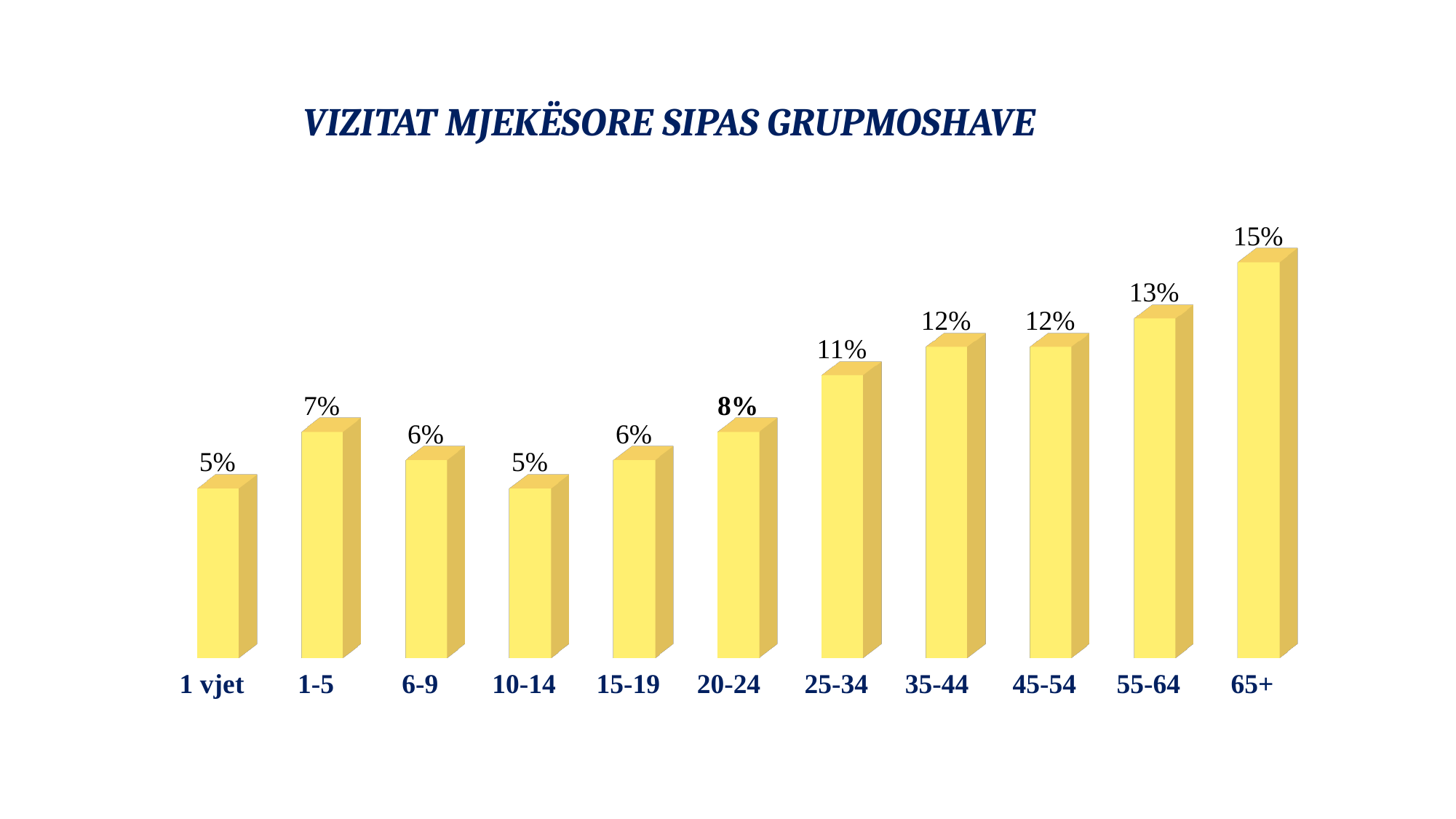
What kind of chart is shown on the slide? Bar chart Do the values generally rise or fall from the 15-19 group to the 65+ group? Rise What is the title of the chart? VIZITAT MJEKËSORE SIPAS GRUPMOSHAVE Which is larger, the value for 15-19 or the value for 20-24? 20-24 Which is larger, the value for 1-5 or the value for 6-9? 1-5 What is the difference between the values for 55-64 and 25-34? 2% What is the value for the 25-34 age group? 11% What is the value for the 20-24 age group? 8% Which age group has the highest value? 65+ What is the difference between the values for 65+ and 1 vjet? 10% What is the value for the 65+ age group? 15% How many age groups are shown in the chart? 11